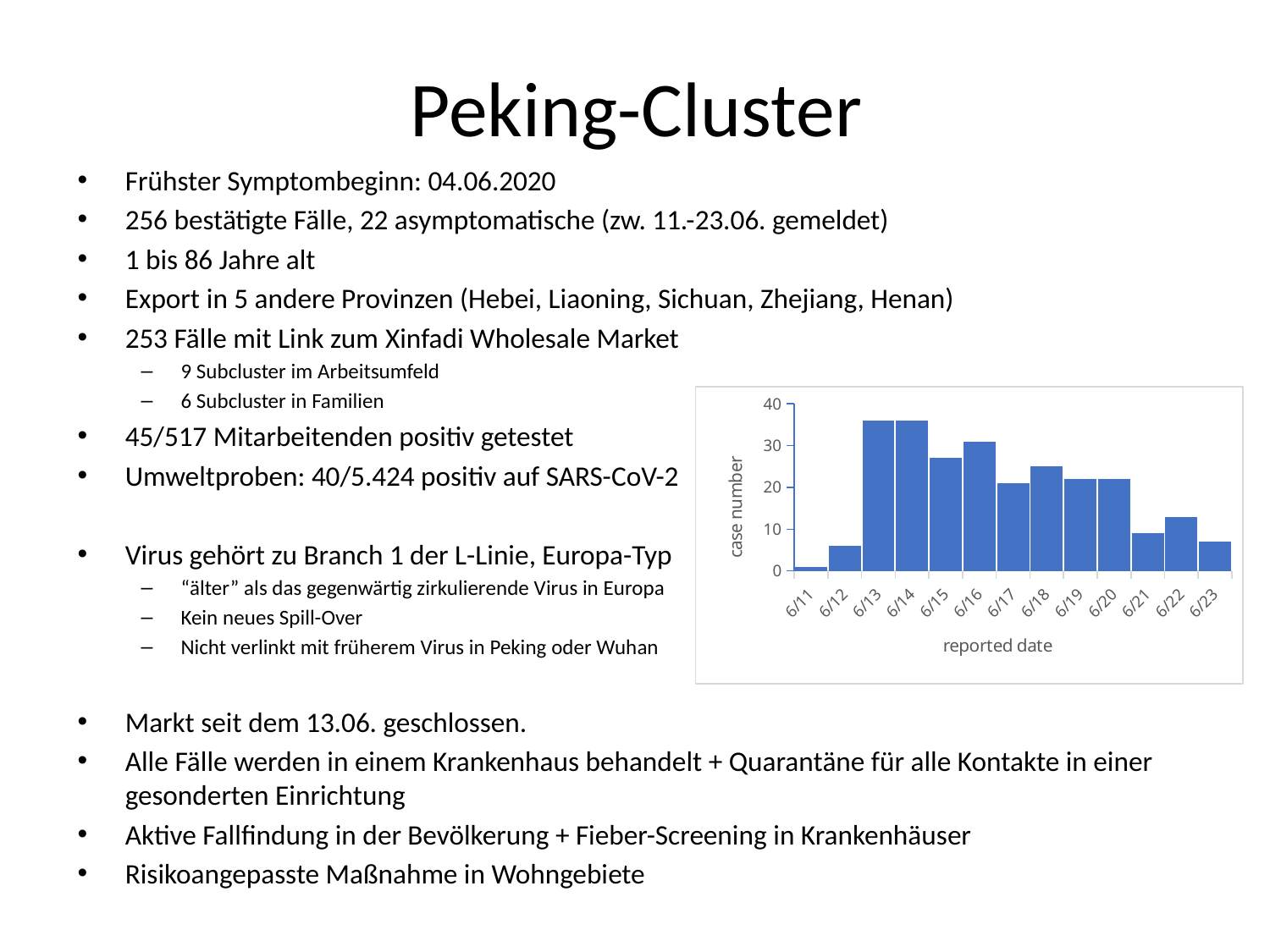
What is the label of the x axis of the chart? reported date Is the case number for 6/18 greater or less than 20? greater Which reported date has the lowest case number in the chart? 6/11 Which has the higher case number, 6/15 or 6/22? 6/15 Is the case number for 6/13 greater or less than 30? greater How many reported dates are shown on the x axis of the chart? 13 What is the label of the y axis of the chart? case number What kind of chart is shown on the slide? bar chart Which has the higher case number, 6/16 or 6/17? 6/16 Is the case number for 6/12 greater or less than 10? less